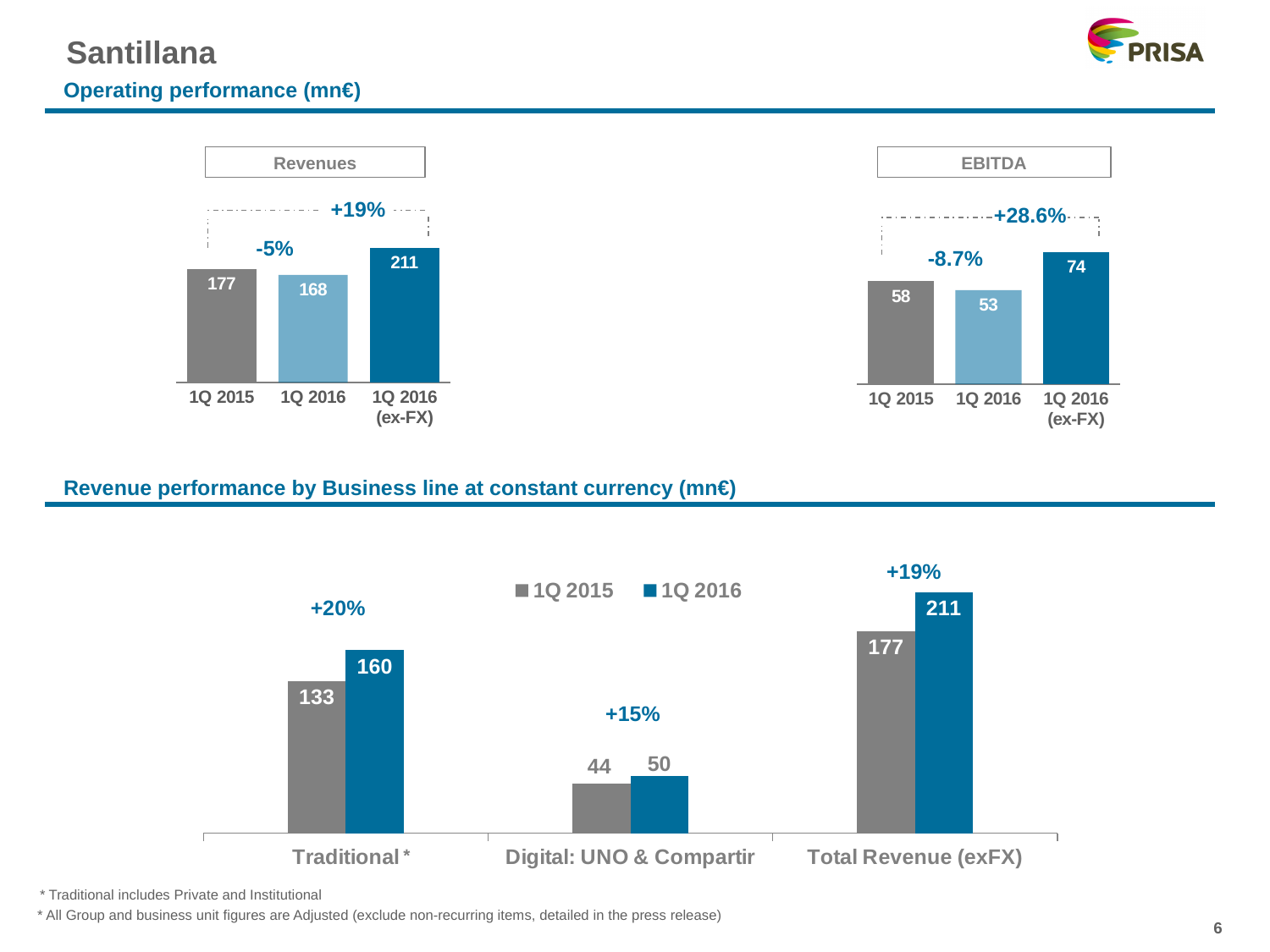
In the Revenues chart, what is the value for 1Q 2016? 168 In the Revenue performance by Business line chart, how many categories are shown on the x axis? 3 In the Revenues chart, what is the difference between the 1Q 2016 (ex-FX) value and the 1Q 2015 value? 34 In the Revenue performance by Business line chart, what is the 1Q 2015 value for Traditional? 133 In the Revenue performance by Business line chart, which is larger: the 1Q 2016 value for Traditional or the 1Q 2016 value for Digital: UNO & Compartir? Traditional In the EBITDA chart, which category has the lowest value? 1Q 2016 What kind of chart is the EBITDA chart? Bar chart In the EBITDA chart, what is the value for 1Q 2016 (ex-FX)? 74 In the Revenue performance by Business line chart, how many series does the legend list? 2 In the Revenues chart, which category has the highest value? 1Q 2016 (ex-FX) In the Revenue performance by Business line chart, what is the 1Q 2016 value for Digital: UNO & Compartir? 50 In the EBITDA chart, what is the difference between the 1Q 2015 value and the 1Q 2016 value? 5